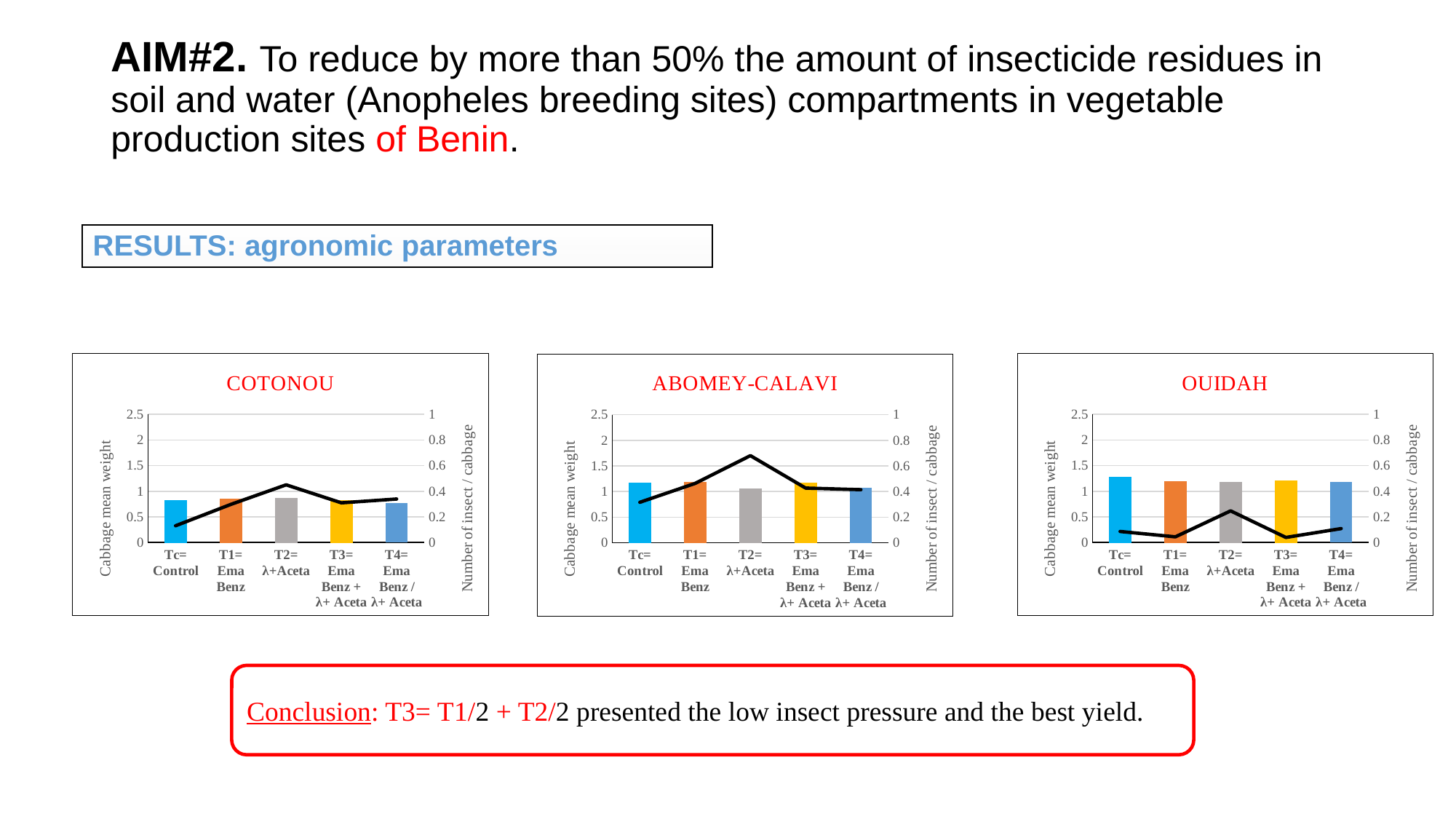
What is the label of the left vertical axis on the ABOMEY-CALAVI chart? Cabbage mean weight How many treatment categories are shown on the x axis of the COTONOU chart? 5 In the ABOMEY-CALAVI chart, is the cabbage mean weight bar for Tc= Control greater or less than 1? greater In the OUIDAH chart, is the cabbage mean weight bar for Tc= Control greater or less than 1? greater In the OUIDAH chart, which treatment has the highest number of insects per cabbage (the line)? T2= λ+Aceta In the COTONOU chart, which treatment has the lowest number of insects per cabbage (the line)? Tc= Control In the ABOMEY-CALAVI chart, is the number of insects per cabbage for T2= λ+Aceta greater or less than 0.6? greater What kind of chart is the OUIDAH chart? bar chart with a line overlay In the ABOMEY-CALAVI chart, which treatment has the highest number of insects per cabbage (the line)? T2= λ+Aceta What is the maximum value shown on the right vertical axis of the COTONOU chart? 1